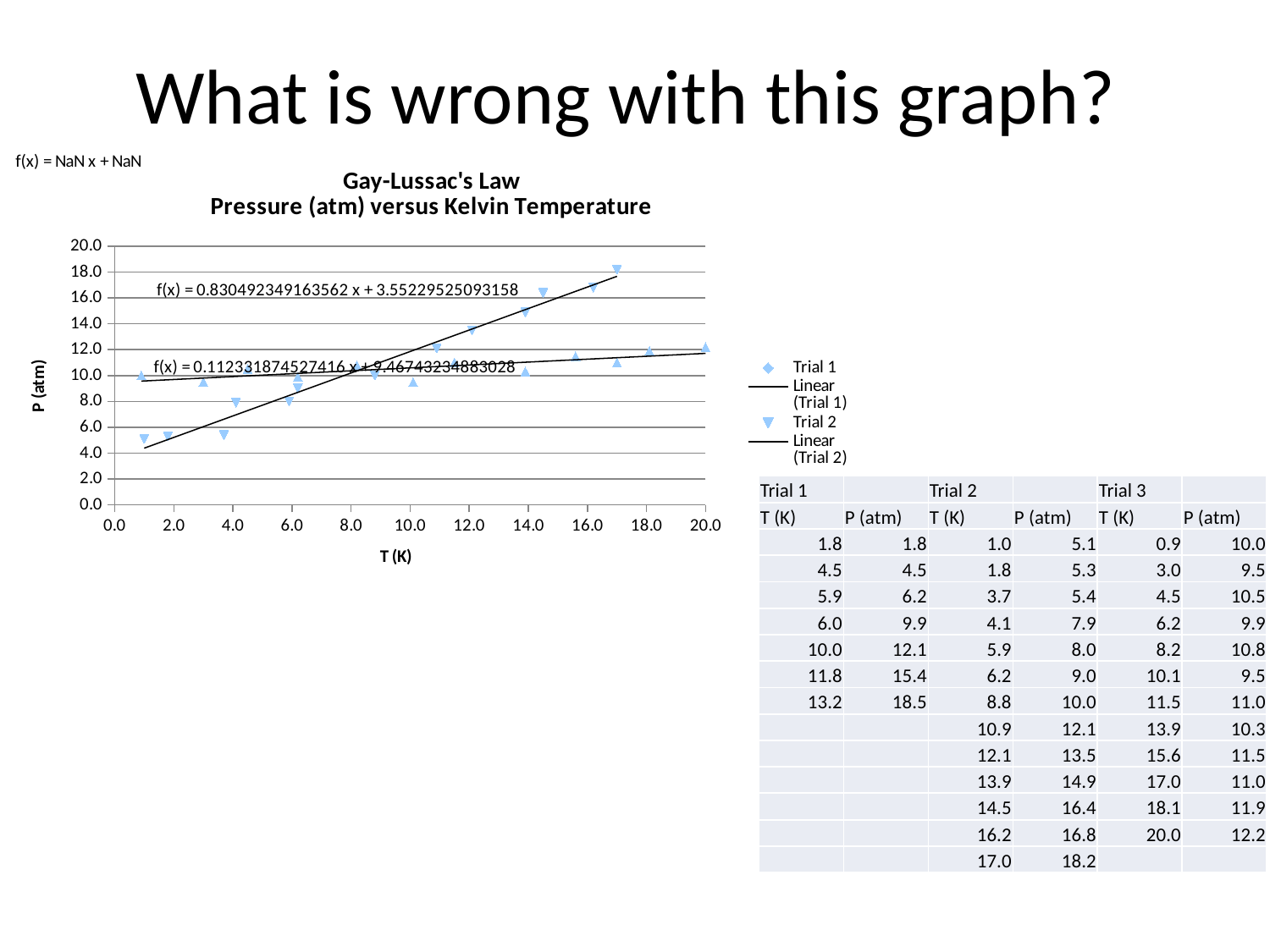
What kind of chart is shown on the slide? scatter chart What is the label on the vertical axis of the chart? P (atm) How many entries does the chart legend list? 4 What equation is printed at the top left of the chart area, above the title? f(x) = NaN x + NaN Do the downward-triangle data points rise or fall as T (K) increases? rise How many tick labels are shown on the horizontal axis of the chart? 11 Which of the two printed trendline equations has the larger slope? f(x) = 0.830492349163562 x + 3.55229525093158 What equation is printed for the flatter trendline on the chart? f(x) = 0.112331874527416 x + 9.46743234883028 What is the title of the chart? Gay-Lussac's Law Pressure (atm) versus Kelvin Temperature What is the highest value shown on the vertical axis of the chart? 20.0 What equation is printed for the steeper trendline on the chart? f(x) = 0.830492349163562 x + 3.55229525093158 What is the highest value shown on the horizontal axis of the chart? 20.0